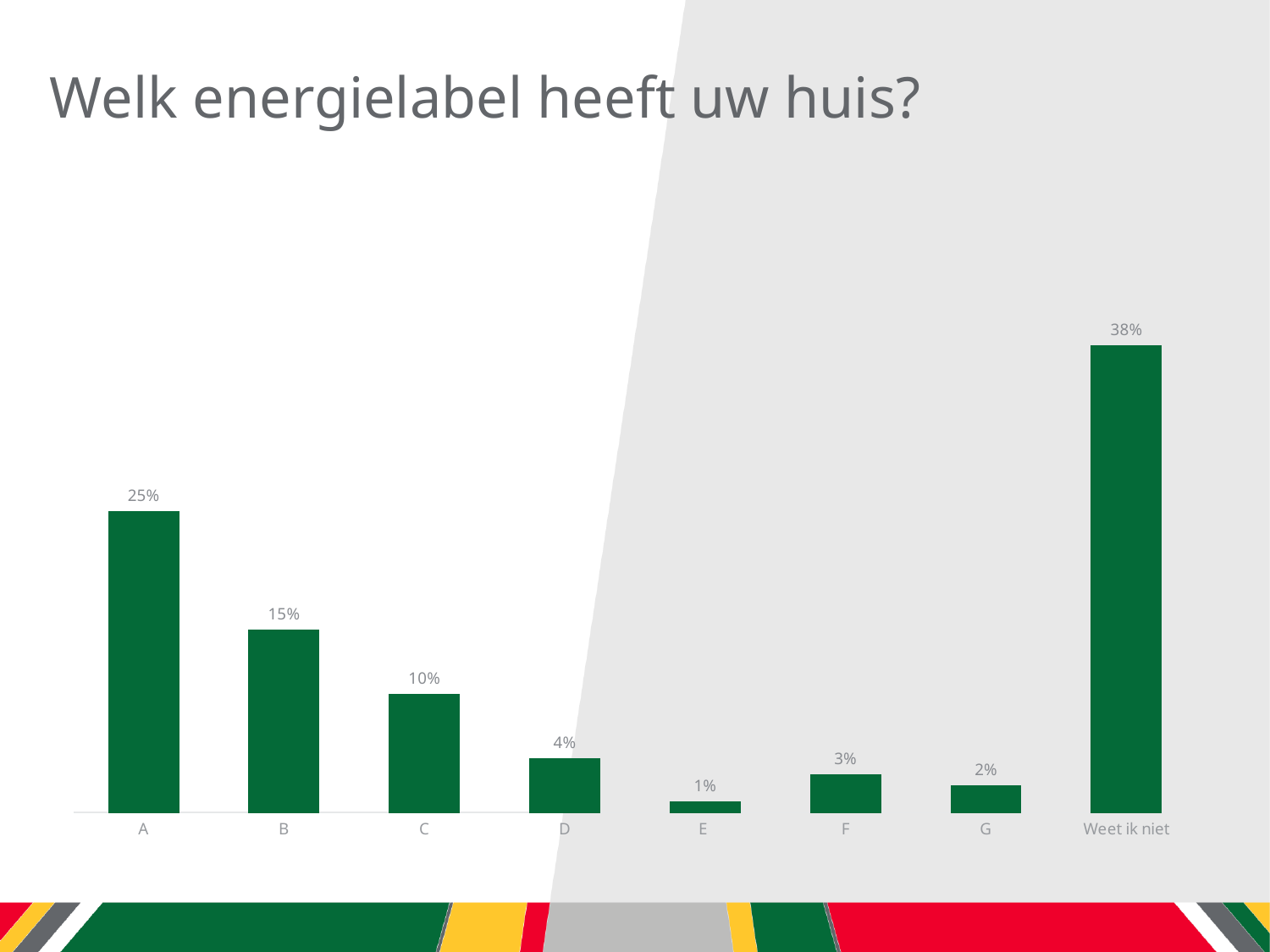
What is the value for category E? 1% Which is larger, the value for F or the value for G? F Which category has the lowest value? E What is the value for category A? 25% Which category has the highest value? Weet ik niet What is the difference between the values for A and B? 10% How many categories are shown on the x axis? 8 What is the value for 'Weet ik niet'? 38% What is the title of the slide? Welk energielabel heeft uw huis? What kind of chart is shown on the slide? Bar chart Do the values rise or fall from A to E along the x axis? Fall What is the difference between 'Weet ik niet' and A? 13%